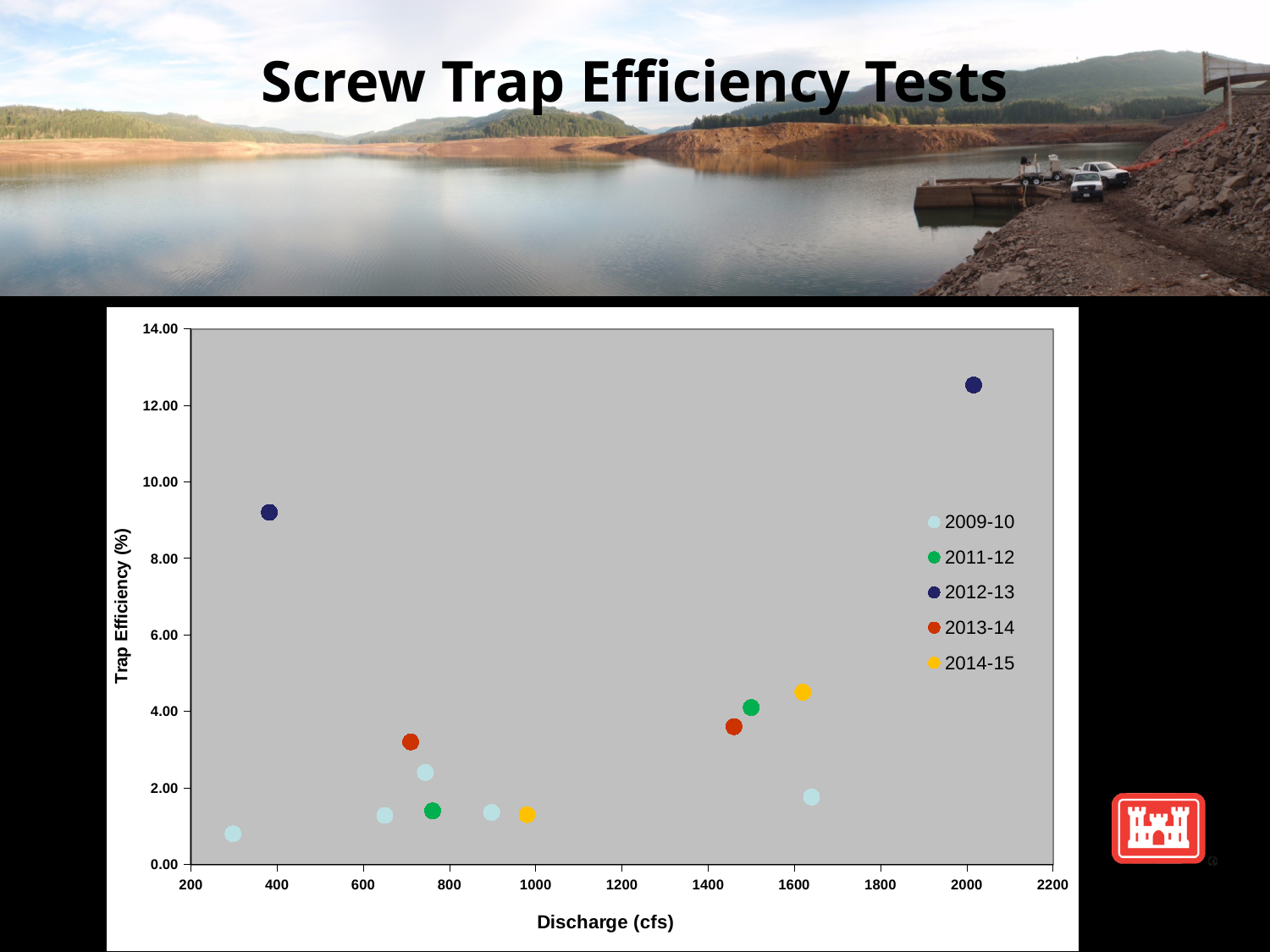
What is the label of the x axis? Discharge (cfs) What kind of chart is shown on the slide? Scatter chart Which series has the point with the highest trap efficiency? 2012-13 How many points are plotted for the 2009-10 series? 5 Is the trap efficiency of the 2012-13 point at about 2000 cfs greater or less than 12.00? greater Is the trap efficiency of the 2012-13 point at about 400 cfs greater or less than 10.00? less What is the label of the y axis? Trap Efficiency (%) Is the trap efficiency of the 2014-15 point at about 1600 cfs greater or less than 4.00? greater Which series has the point with the lowest trap efficiency? 2009-10 Which has the higher trap efficiency: the 2012-13 point at about 2000 cfs or the 2011-12 point at about 1500 cfs? 2012-13 point at about 2000 cfs How many series does the legend list? 5